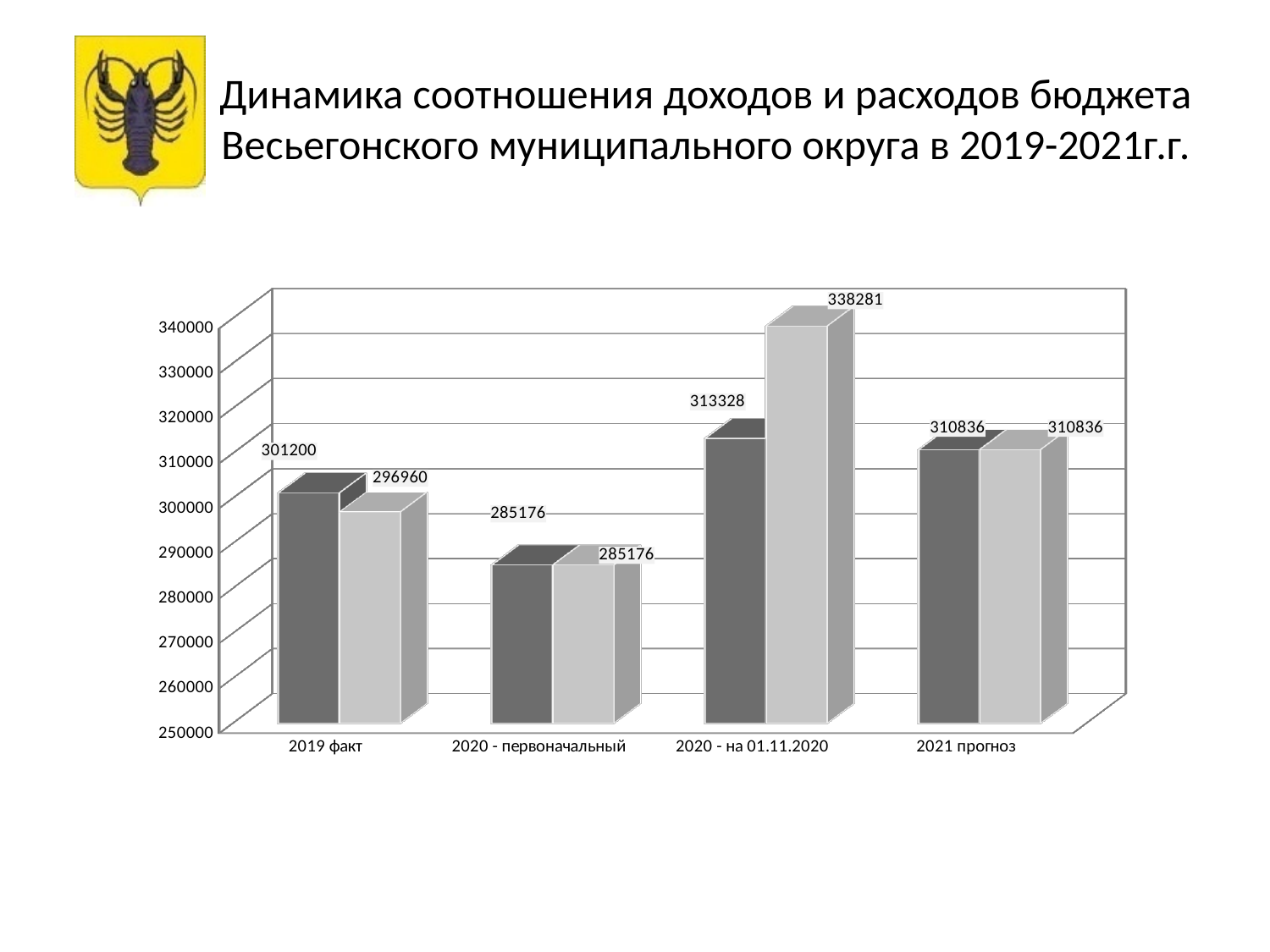
What is the value of the light grey bar for "2019 факт"? 296960 What is the value of the dark grey bar for "2019 факт"? 301200 What is the value of the dark grey bar for "2021 прогноз"? 310836 What is the value of the light grey bar for "2020 - на 01.11.2020"? 338281 What is the title of the slide? Динамика соотношения доходов и расходов бюджета Весьегонского муниципального округа в 2019-2021г.г. What is the difference between the light grey and dark grey bars for "2020 - на 01.11.2020"? 24953 For "2019 факт", which bar is larger, the dark grey or the light grey one? dark grey Which category has the highest light grey bar? 2020 - на 01.11.2020 How many categories are shown on the x axis? 4 What type of chart is shown on the slide? bar chart Which category has the lowest dark grey bar? 2020 - первоначальный Does the dark grey bar rise or fall from "2020 - первоначальный" to "2020 - на 01.11.2020"? rise